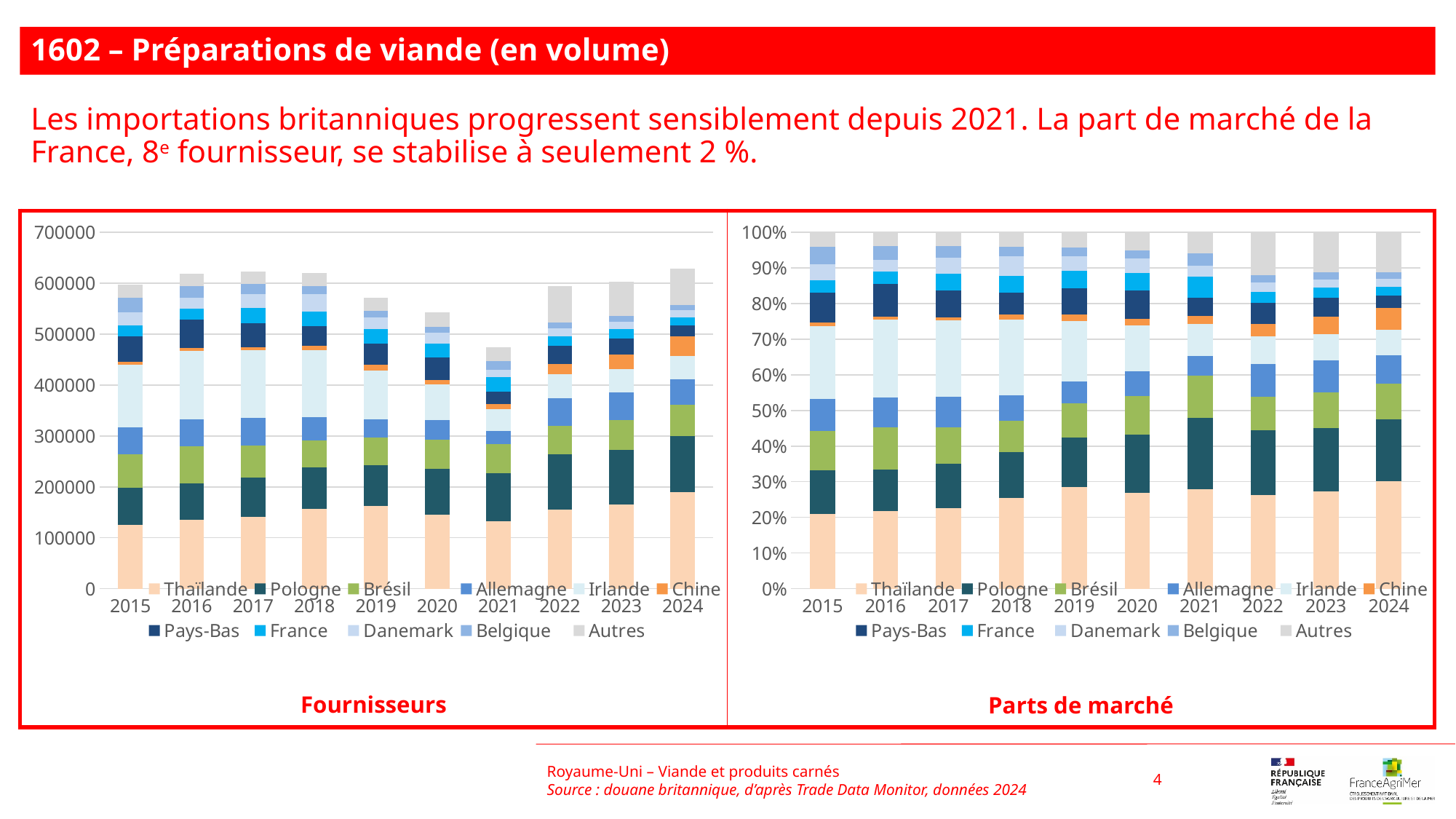
Which series is listed first in the legend of the 'Fournisseurs' chart? Thaïlande In the 'Parts de marché' chart, is the share of Thaïlande in 2018 greater or less than 30%? less In the 'Fournisseurs' chart, do the total bars rise or fall from 2021 to 2024? rise How many series does the legend of the 'Parts de marché' chart list? 11 What kind of chart is the 'Fournisseurs' chart on the left? Stacked bar chart What is the title of the chart on the right side of the slide? Parts de marché In the 'Fournisseurs' chart, is the total for 2024 greater or less than 600000? greater In the 'Fournisseurs' chart, is the total for 2020 greater or less than 600000? less In the 'Fournisseurs' chart, which total bar is larger, 2021 or 2024? 2024 In the 'Fournisseurs' chart, which year has the lowest total bar? 2021 How many years are shown on the x axis of the 'Fournisseurs' chart? 10